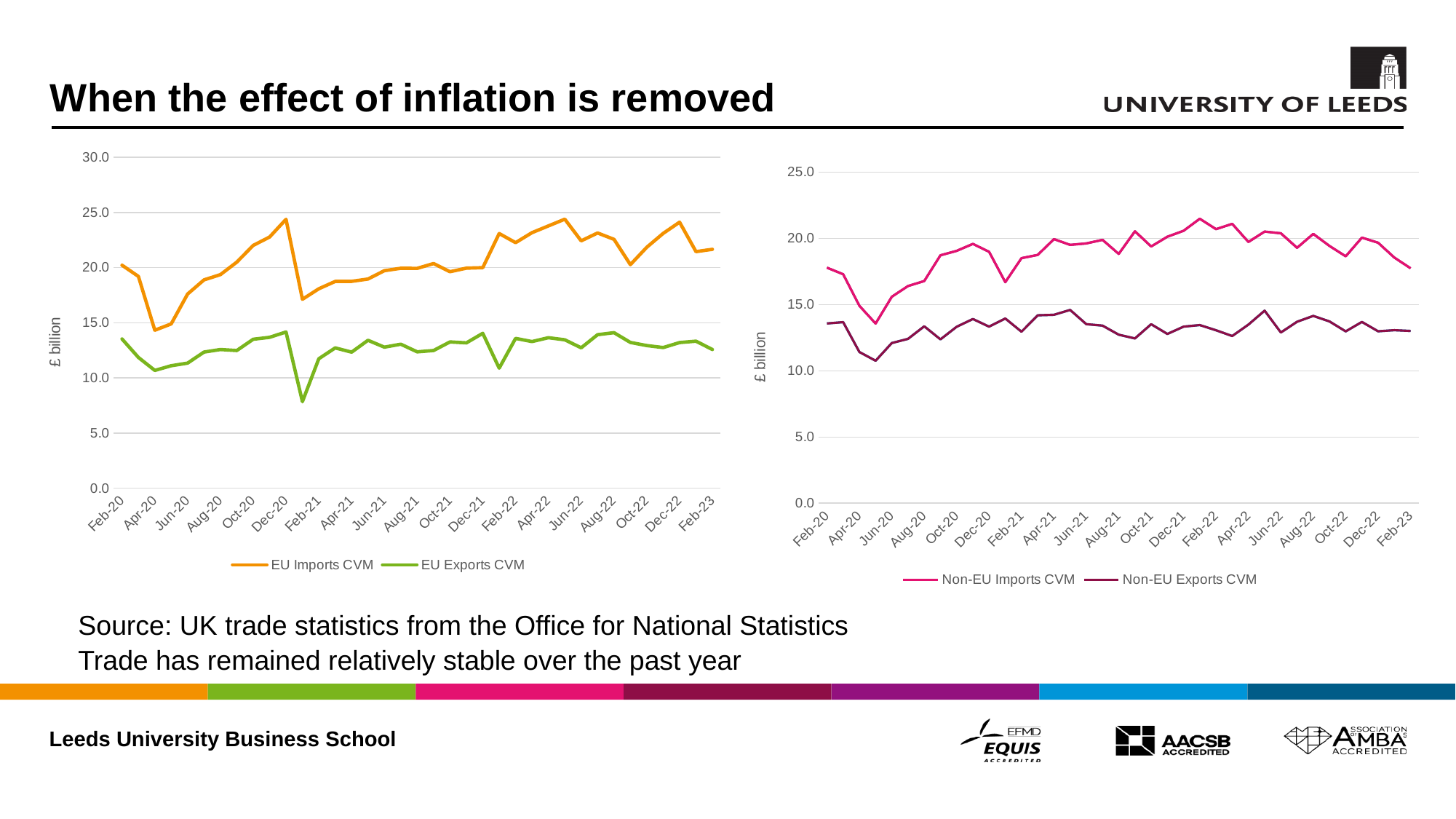
How many series does the legend of the right chart (Non-EU trade) list? 2 What is the y-axis title of the left chart? £ billion In the right chart, is the value for Non-EU Exports CVM in Feb-23 greater or less than 15.0? less In the left chart, is the value for EU Exports CVM in Feb-21 greater or less than 10.0? greater What kind of chart is the left chart showing EU Imports CVM and EU Exports CVM? line chart In the right chart, does Non-EU Imports CVM rise or fall between Feb-20 and Jun-20? fall What colour is the EU Imports CVM line in the left chart? orange In the left chart, is the value for EU Imports CVM in Dec-20 greater or less than 20.0? greater In the left chart, which series is higher in Feb-23, EU Imports CVM or EU Exports CVM? EU Imports CVM In the right chart, which series is higher in Jun-21, Non-EU Imports CVM or Non-EU Exports CVM? Non-EU Imports CVM